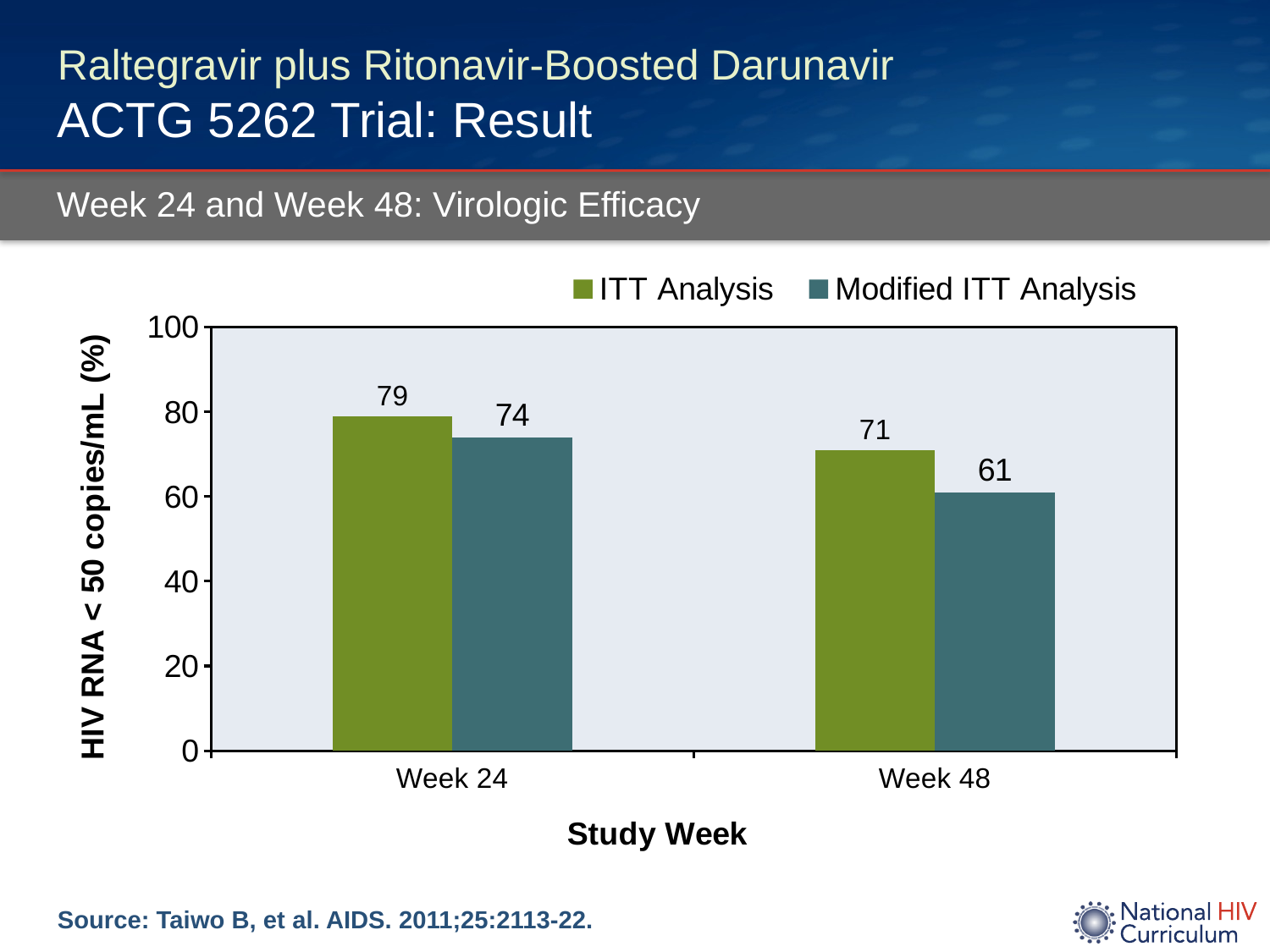
Do the Modified ITT Analysis values rise or fall from Week 24 to Week 48? Fall Which is larger at Week 24: the ITT Analysis value or the Modified ITT Analysis value? ITT Analysis What is the ITT Analysis value at Week 24? 79 Which bar shows the lowest value on the chart? Modified ITT Analysis at Week 48 Which study week has the highest ITT Analysis value? Week 24 How many series does the legend list? 2 What is the Modified ITT Analysis value at Week 48? 61 What is the Modified ITT Analysis value at Week 24? 74 What kind of chart is shown on the slide? Bar chart By how much does the ITT Analysis value drop from Week 24 to Week 48? 8 How many study weeks are shown on the x axis? 2 What is the difference between the ITT Analysis and Modified ITT Analysis values at Week 48? 10